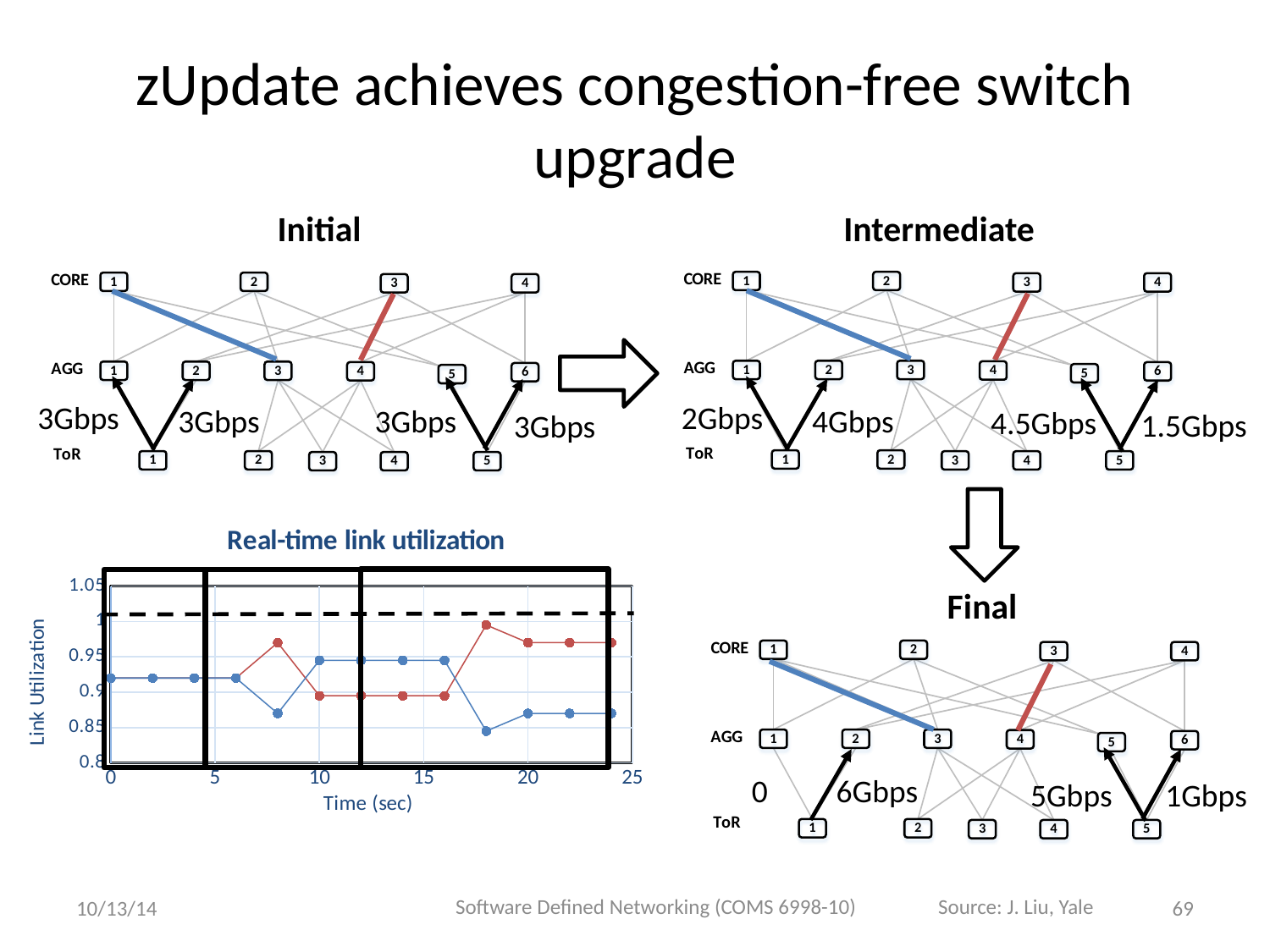
In the "Real-time link utilization" chart, is the red line's value at time 18 greater or less than 0.95? greater In the "Real-time link utilization" chart, does the blue line rise or fall between time 16 and time 18? fall What is the x-axis label of the "Real-time link utilization" chart? Time (sec) In the "Real-time link utilization" chart, which line has the higher value at time 20, the red or the blue? red In the "Real-time link utilization" chart, is the red line's value at time 8 greater or less than 0.95? greater In the "Real-time link utilization" chart, is the blue line's value at time 12 greater or less than 0.9? greater What is the title of the chart on the slide? Real-time link utilization In the "Real-time link utilization" chart, does the red line rise or fall between time 16 and time 18? rise In the "Real-time link utilization" chart, which line has the higher value at time 12, the red or the blue? blue What kind of chart is the "Real-time link utilization" chart? line chart